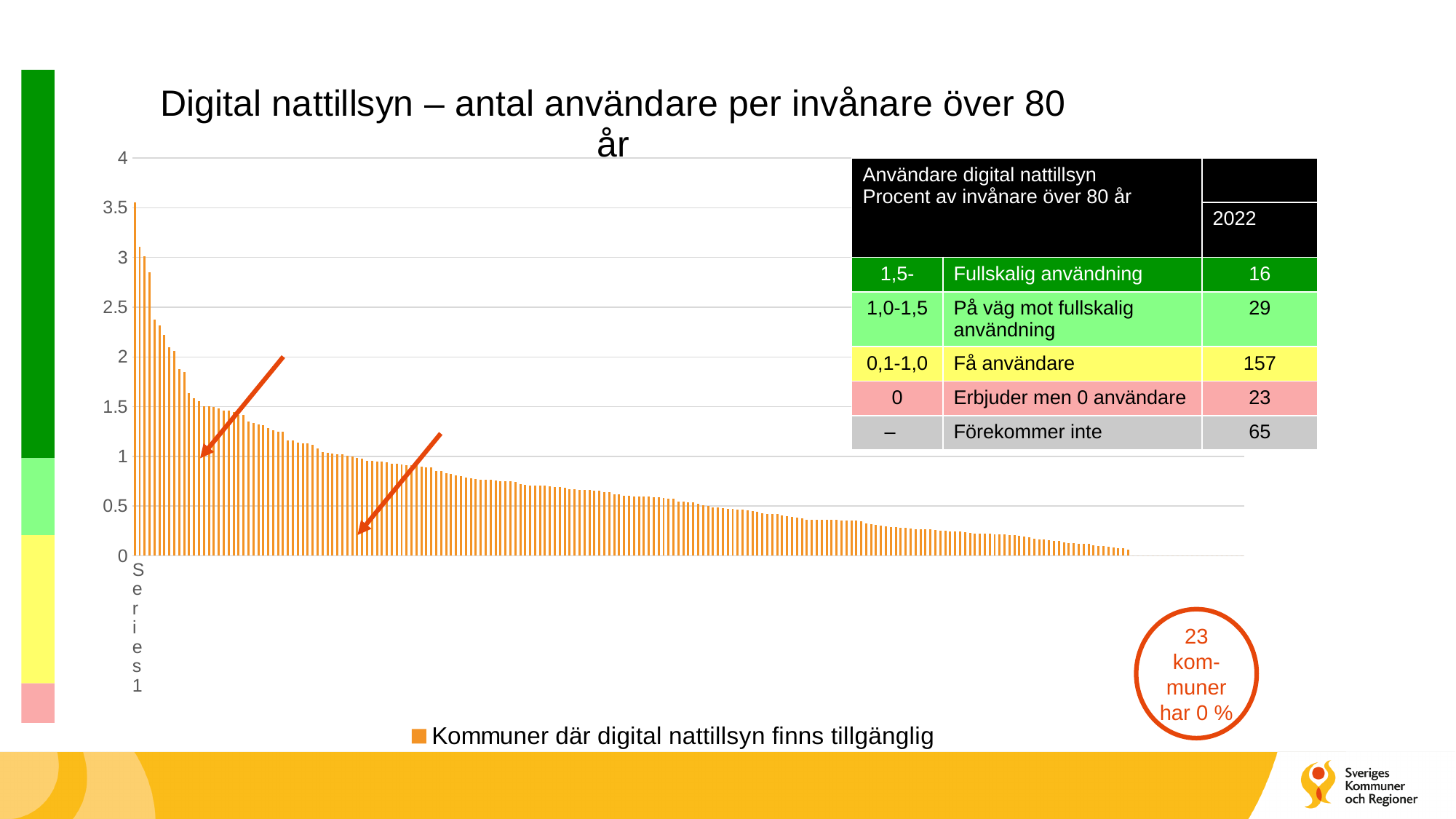
What is the highest value shown on the chart's vertical axis? 4 Is the value of the tallest bar in the chart greater or less than 3? greater Do the bar values rise or fall from left to right along the x axis? Fall What is the legend entry of the chart? Kommuner där digital nattillsyn finns tillgänglig Is the value of the tallest bar in the chart greater or less than 4? less What kind of chart is shown on the slide? Bar chart How many series does the chart legend list? 1 Is the value of the shortest bar at the right end of the chart greater or less than 0.5? less